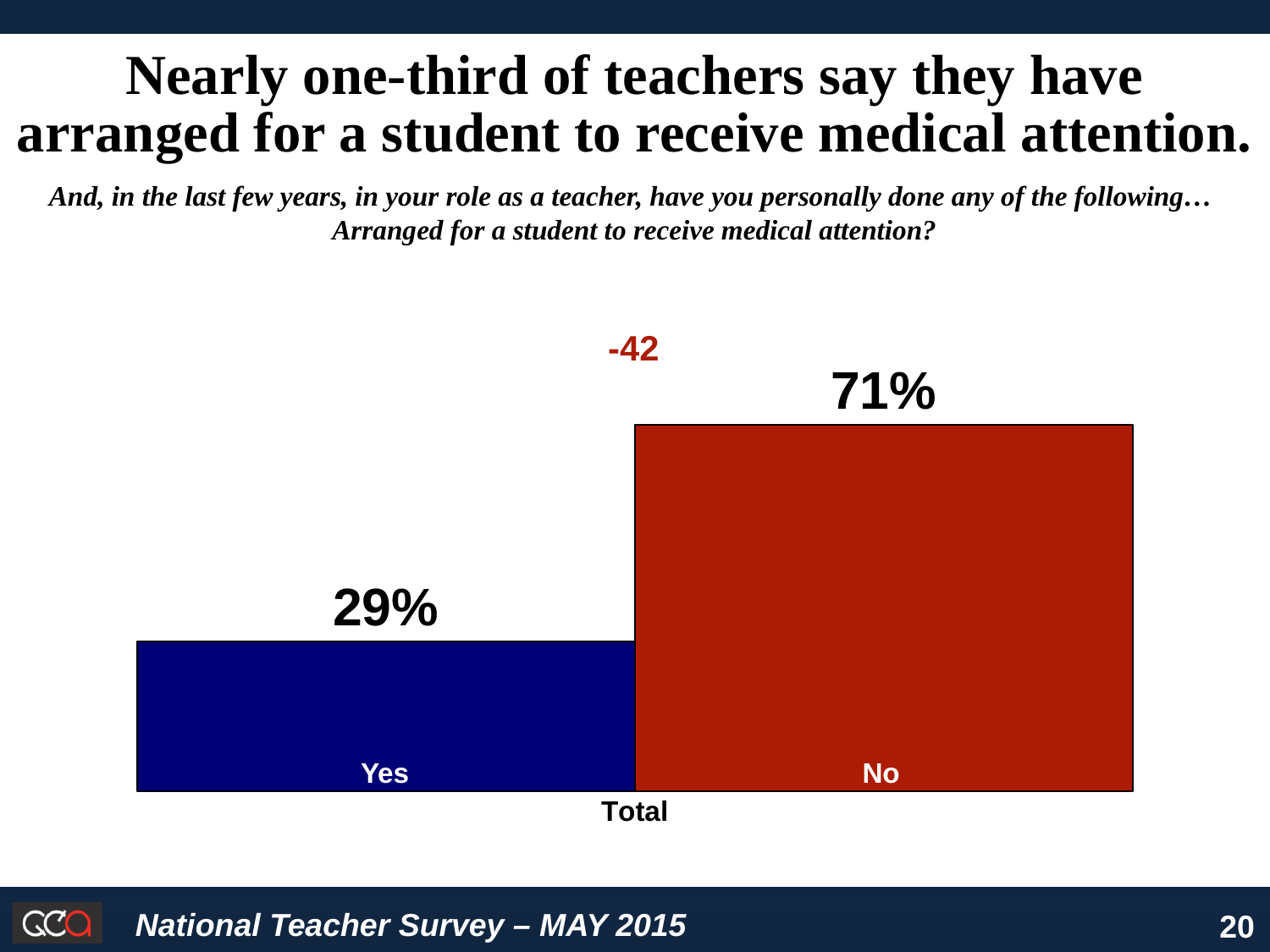
How many bars are shown in the chart? 2 What percentage of teachers answered Yes? 29% Which response has the higher value, Yes or No? No What percentage of teachers answered No? 71% What is the category label shown beneath the two bars? Total What is the total of the Yes and No percentages? 100% What net figure is printed in red above the bars? -42 Which response has the lower value, Yes or No? Yes Is the value for Yes larger or smaller than the value for No? smaller What kind of chart is shown on the slide? bar chart What is the difference between the No and Yes percentages? 42 percentage points